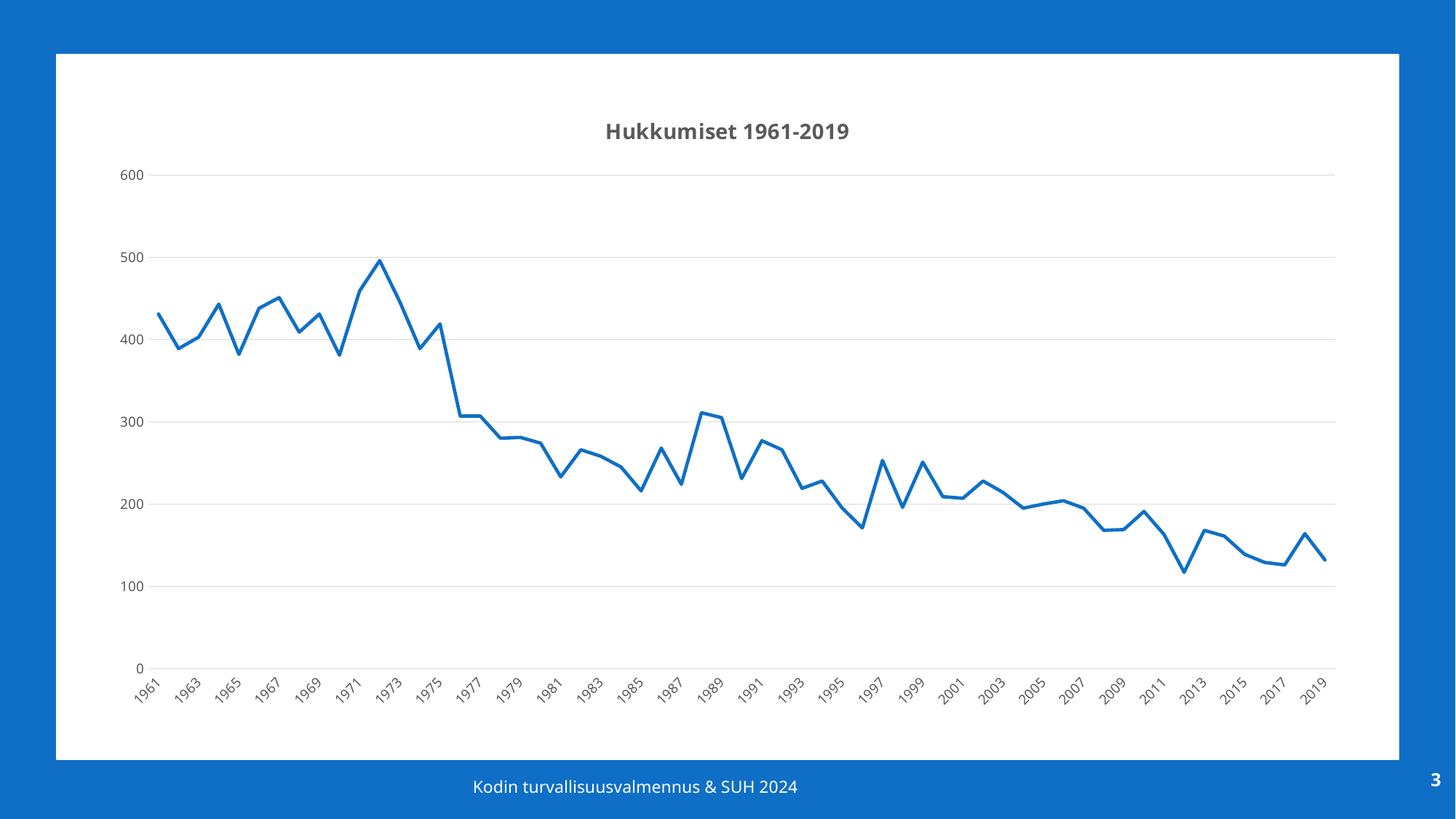
Is the value for 1961 greater or less than 400? greater What kind of chart is shown on the slide? line chart Which year has the larger value, 1972 or 1989? 1972 Overall, do the values rise or fall from 1961 to 2019? fall Is the value for 1965 greater or less than 400? less In which year does the line reach its highest value? 1972 Is the value for 2012 greater or less than 100? greater What is the title of the chart? Hukkumiset 1961-2019 How many lines are plotted on the chart? 1 Which year has the larger value, 1961 or 2019? 1961